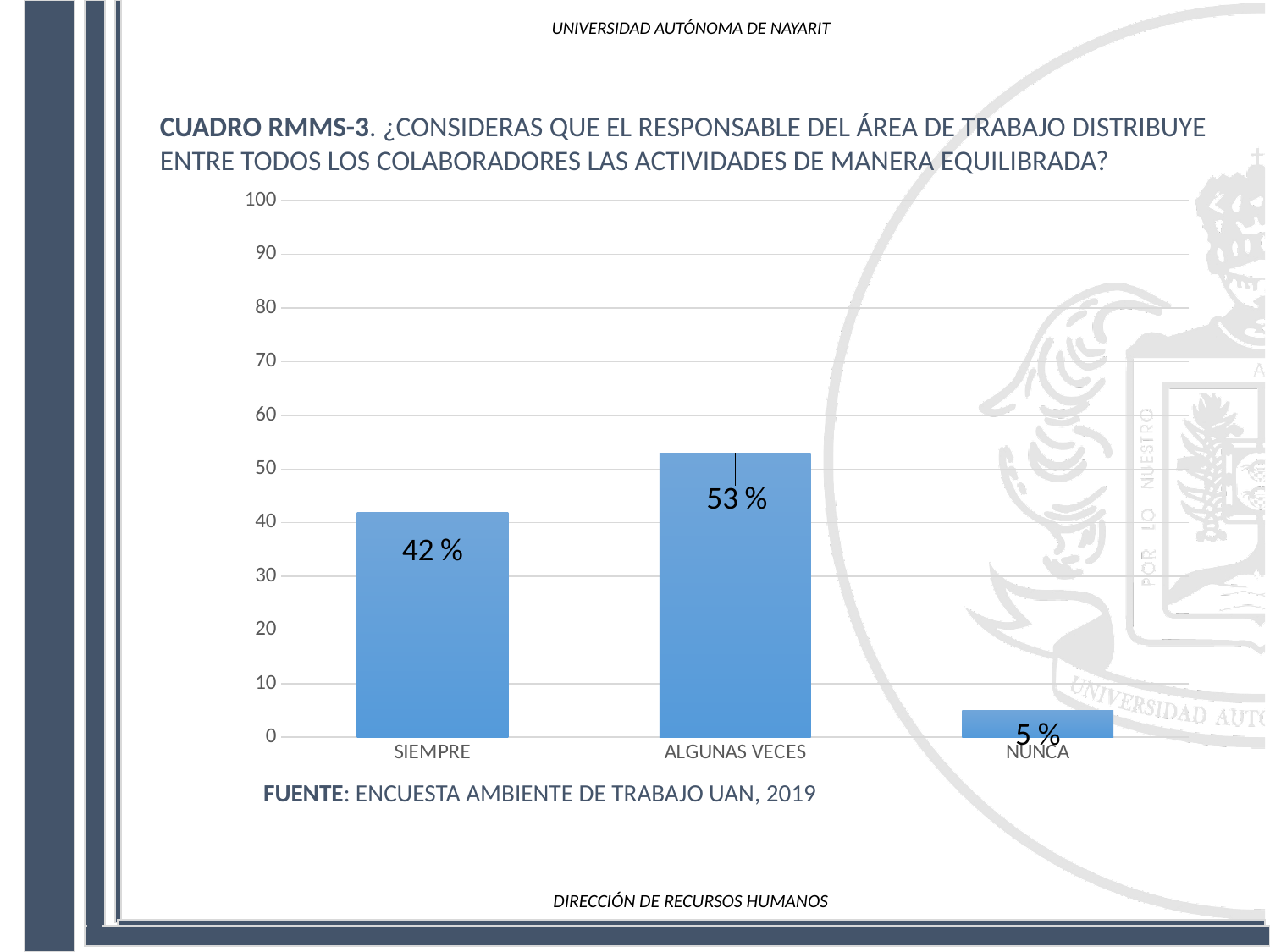
What is the value for SIEMPRE? 42 % What is the difference between the values for ALGUNAS VECES and SIEMPRE? 11 % What is the value for NUNCA? 5 % Which is larger, the value for SIEMPRE or the value for NUNCA? SIEMPRE Which category has the highest value? ALGUNAS VECES What kind of chart is shown on the slide? bar chart Is the value for ALGUNAS VECES greater or less than 50? greater Which category has the lowest value? NUNCA What is the difference between the values for SIEMPRE and NUNCA? 37 % What source is cited below the chart? ENCUESTA AMBIENTE DE TRABAJO UAN, 2019 What is the value for ALGUNAS VECES? 53 % How many categories are shown on the x axis? 3